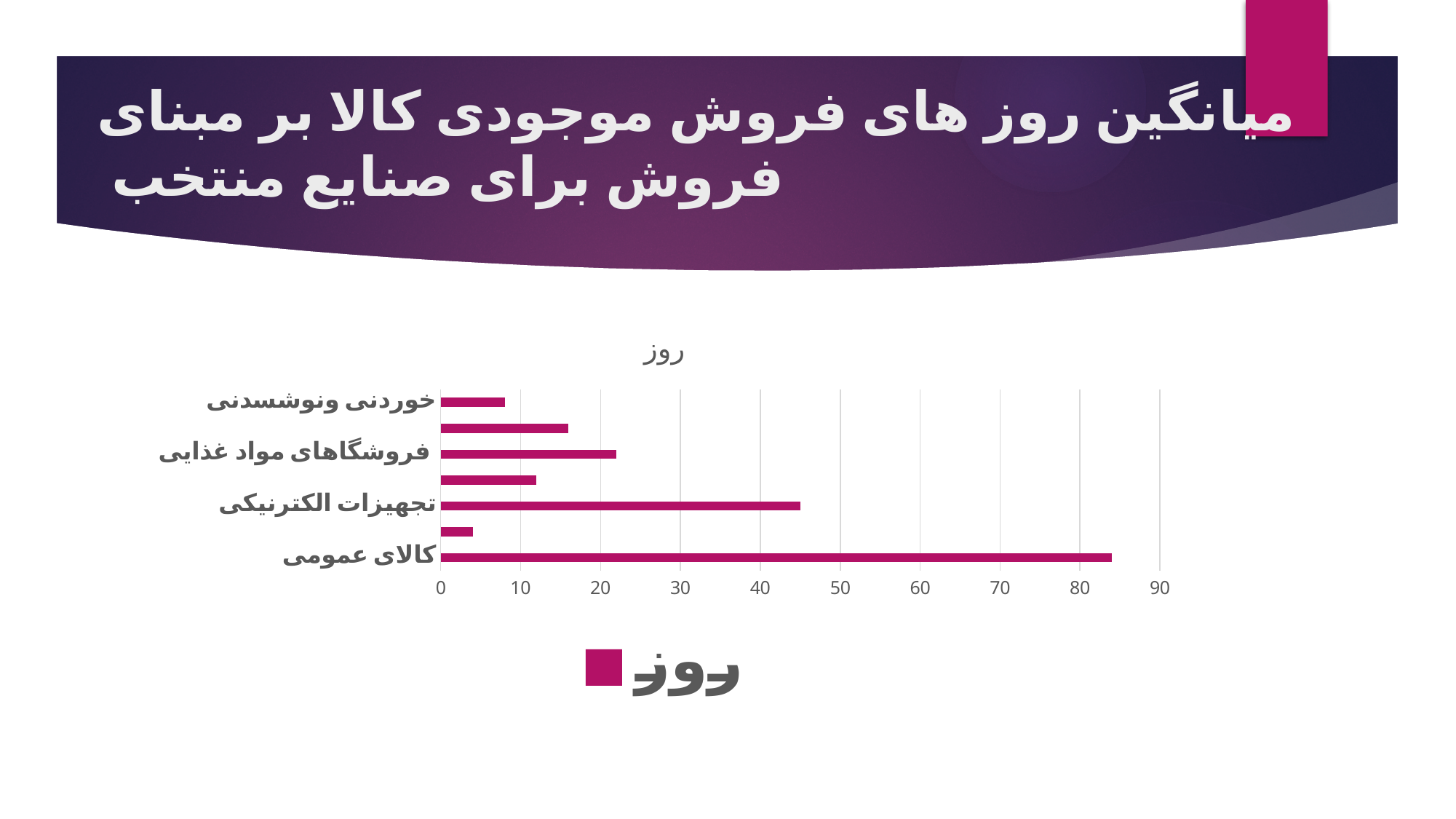
Which is larger, the value for کالای عمومی or the value for تجهیزات الکترنیکی? کالای عمومی How many series does the legend list? 1 Which category has the highest value? کالای عمومی What kind of chart is shown on the slide? bar chart What is the legend entry shown below the chart? روز Is the value for خوردنی ونوشیدنی greater or less than 10? less Is the value for کالای عمومی greater or less than 80? greater Which is larger, the value for تجهیزات الکترنیکی or the value for فروشگاه‌های مواد غذایی? تجهیزات الکترنیکی Is the value for فروشگاه‌های مواد غذایی greater or less than 30? less How many bars are plotted in the chart? 7